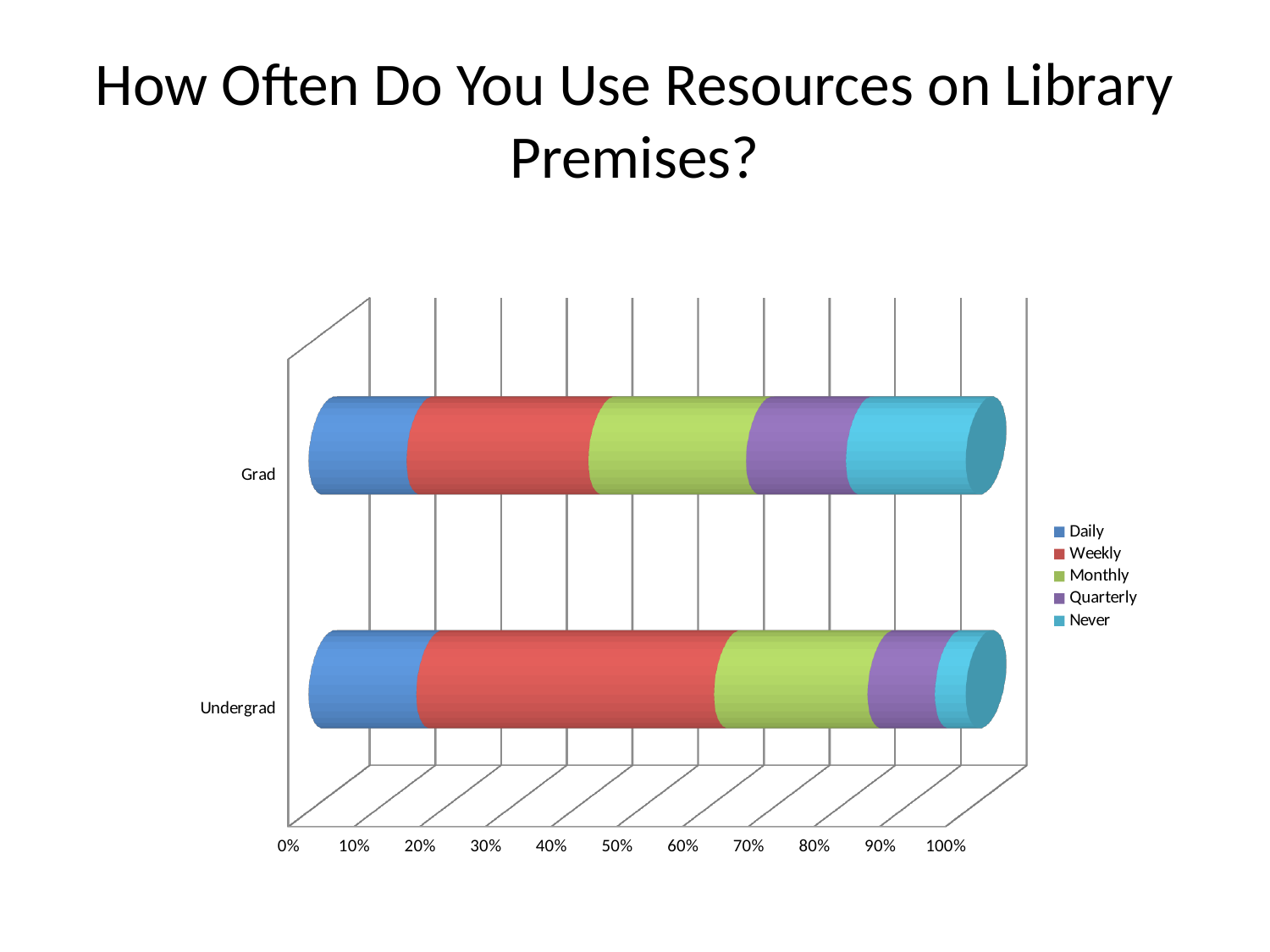
Which series makes up the largest share of the Undergrad bar? Weekly Is the Never value for Undergrad greater or less than 10%? less Which series is shown in red in the legend? Weekly Is the Never share larger for Grad or for Undergrad? Grad How many series does the legend list? 5 Is the Weekly share larger for Grad or for Undergrad? Undergrad Which series makes up the smallest share of the Undergrad bar? Never How many categories are shown on the vertical axis? 2 Is the Never value for Grad greater or less than 10%? greater Is the Weekly value for Undergrad greater or less than 30%? greater What is the title of the chart? How Often Do You Use Resources on Library Premises? What kind of chart is shown on the slide? Stacked bar chart